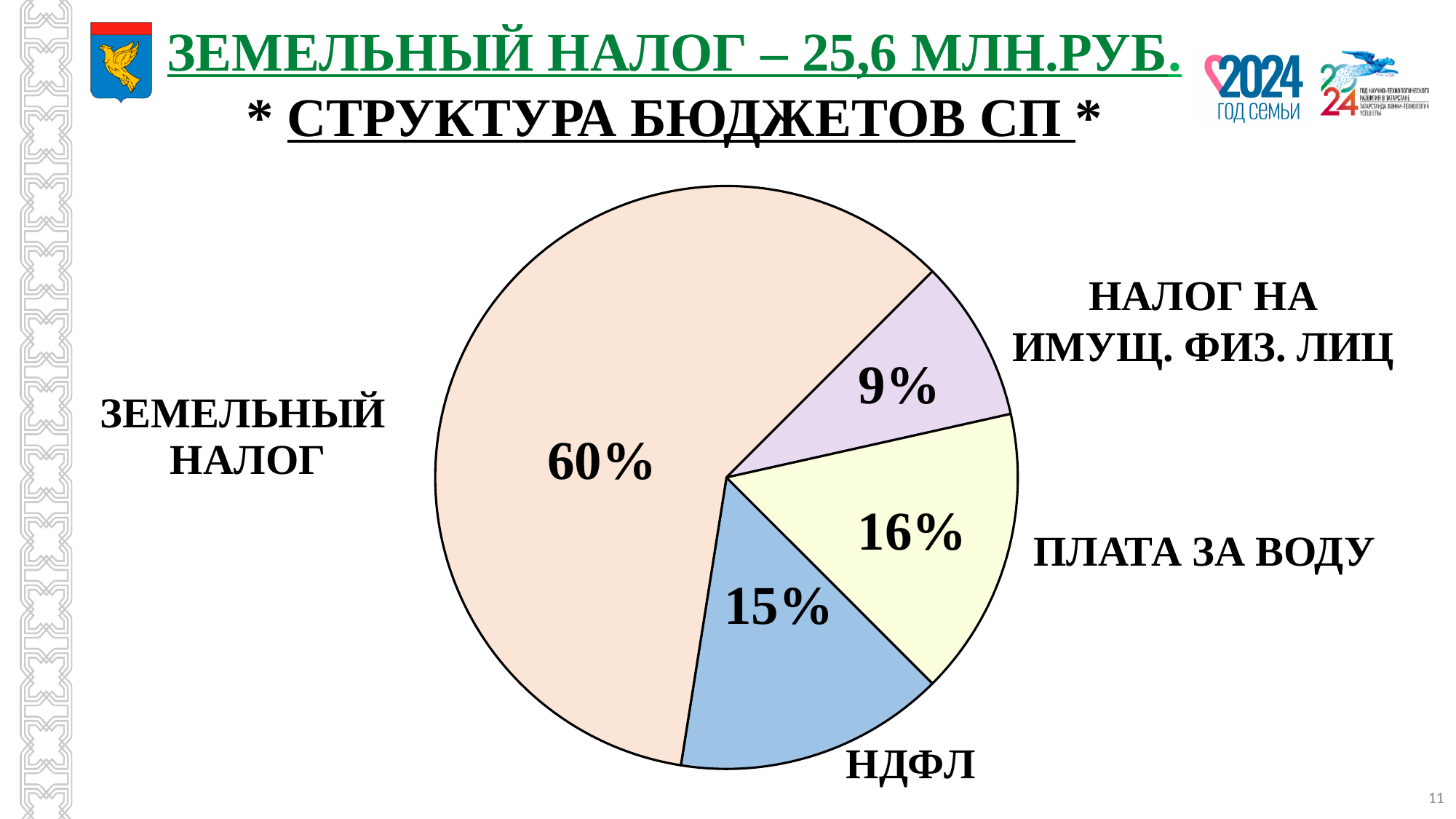
What share of the pie does ЗЕМЕЛЬНЫЙ НАЛОГ account for? 60% How many slices does the pie chart have? 4 What is the value shown for НДФЛ? 15% What is the difference between the shares of ЗЕМЕЛЬНЫЙ НАЛОГ and НДФЛ? 45% What is the total amount of ЗЕМЕЛЬНЫЙ НАЛОГ stated in the slide title? 25,6 МЛН.РУБ. Which category has the smallest slice of the pie? НАЛОГ НА ИМУЩ. ФИЗ. ЛИЦ What kind of chart is shown on the slide? Pie chart Which category has the largest slice of the pie? ЗЕМЕЛЬНЫЙ НАЛОГ What is the value shown for НАЛОГ НА ИМУЩ. ФИЗ. ЛИЦ? 9% What is the difference between the shares of ПЛАТА ЗА ВОДУ and НАЛОГ НА ИМУЩ. ФИЗ. ЛИЦ? 7% What is the value shown for ПЛАТА ЗА ВОДУ? 16% Which is larger, the share for ПЛАТА ЗА ВОДУ or the share for НДФЛ? ПЛАТА ЗА ВОДУ